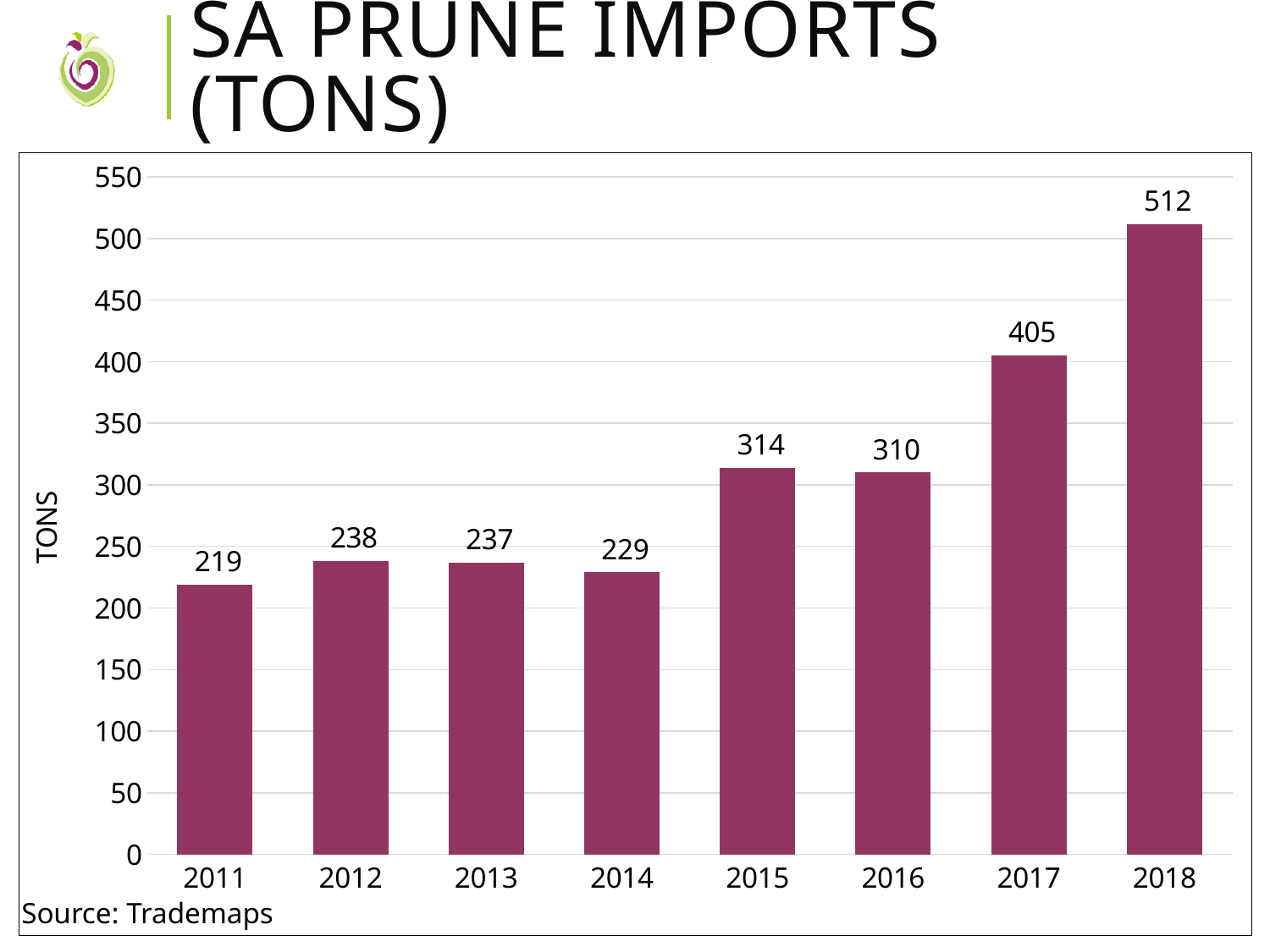
What is the difference in prune imports between 2015 and 2014? 85 What is the label on the vertical axis of the chart? TONS Do SA prune imports generally rise or fall from 2011 to 2018? Rise What is the difference in prune imports between 2018 and 2017? 107 Which year had the lowest SA prune imports? 2011 What was the value of SA prune imports in 2011? 219 Which year had higher prune imports, 2012 or 2014? 2012 How many years are shown on the chart? 8 What was the value of SA prune imports in 2015? 314 Which year had the highest SA prune imports? 2018 Is the value for 2017 greater or less than 400? greater What kind of chart is shown on the slide? Bar chart